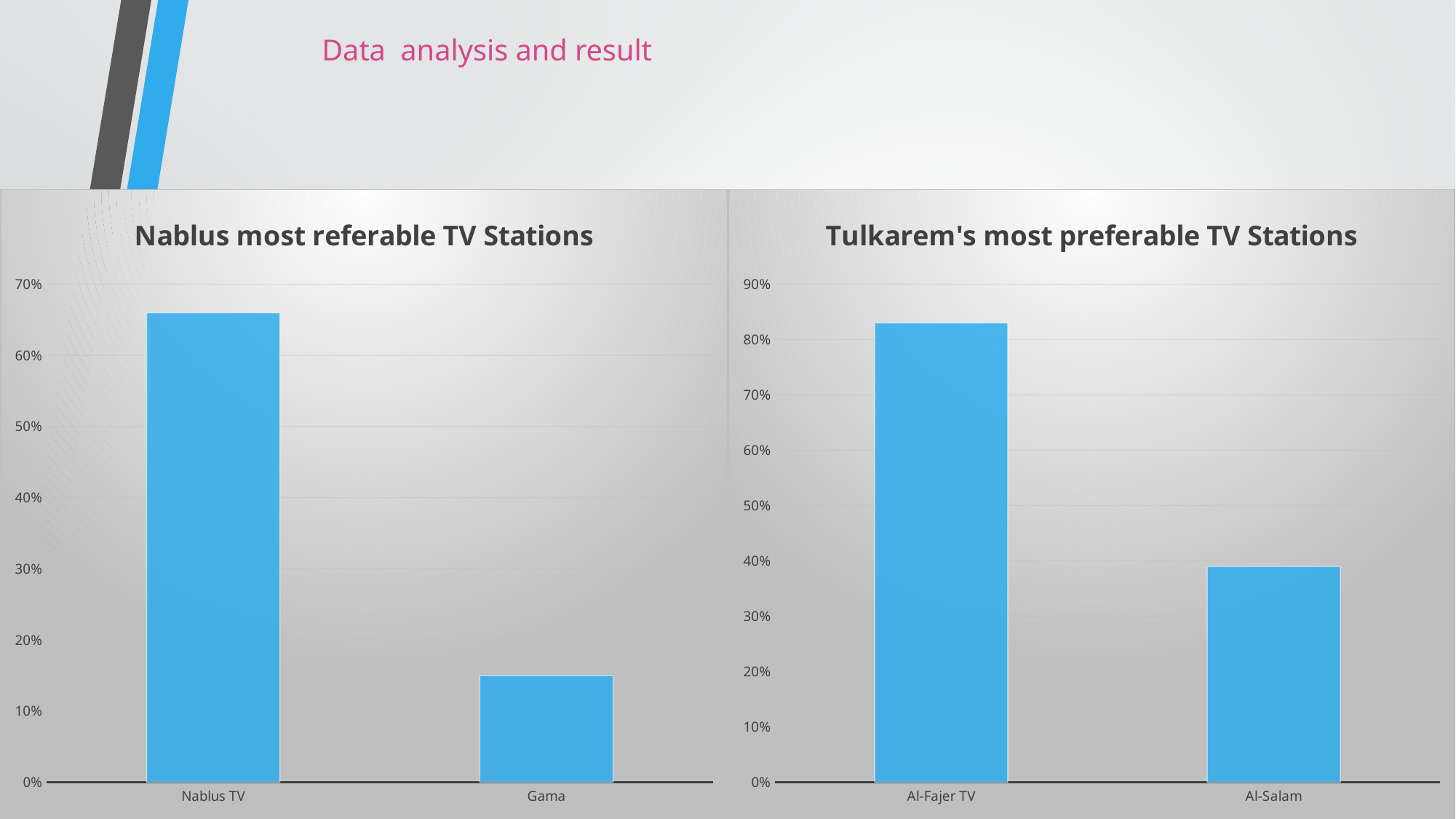
What is the highest value shown on the vertical axis of the 'Tulkarem's most preferable TV Stations' chart? 90% In the 'Tulkarem's most preferable TV Stations' chart, is the value for Al-Salam greater or less than 30%? greater What type of chart is the 'Tulkarem's most preferable TV Stations' chart? Bar chart In the 'Tulkarem's most preferable TV Stations' chart, is the value for Al-Fajer TV greater or less than 80%? greater In the 'Nablus most referable TV Stations' chart, which TV station has the lowest value? Gama In the 'Nablus most referable TV Stations' chart, is the value for Nablus TV greater or less than 60%? greater In the 'Tulkarem's most preferable TV Stations' chart, which is larger, the value for Al-Fajer TV or Al-Salam? Al-Fajer TV In the 'Nablus most referable TV Stations' chart, which TV station has the highest value? Nablus TV In the 'Nablus most referable TV Stations' chart, how many TV stations are shown? 2 What is the title of the chart on the left side of the slide? Nablus most referable TV Stations In the 'Tulkarem's most preferable TV Stations' chart, which TV station has the highest value? Al-Fajer TV